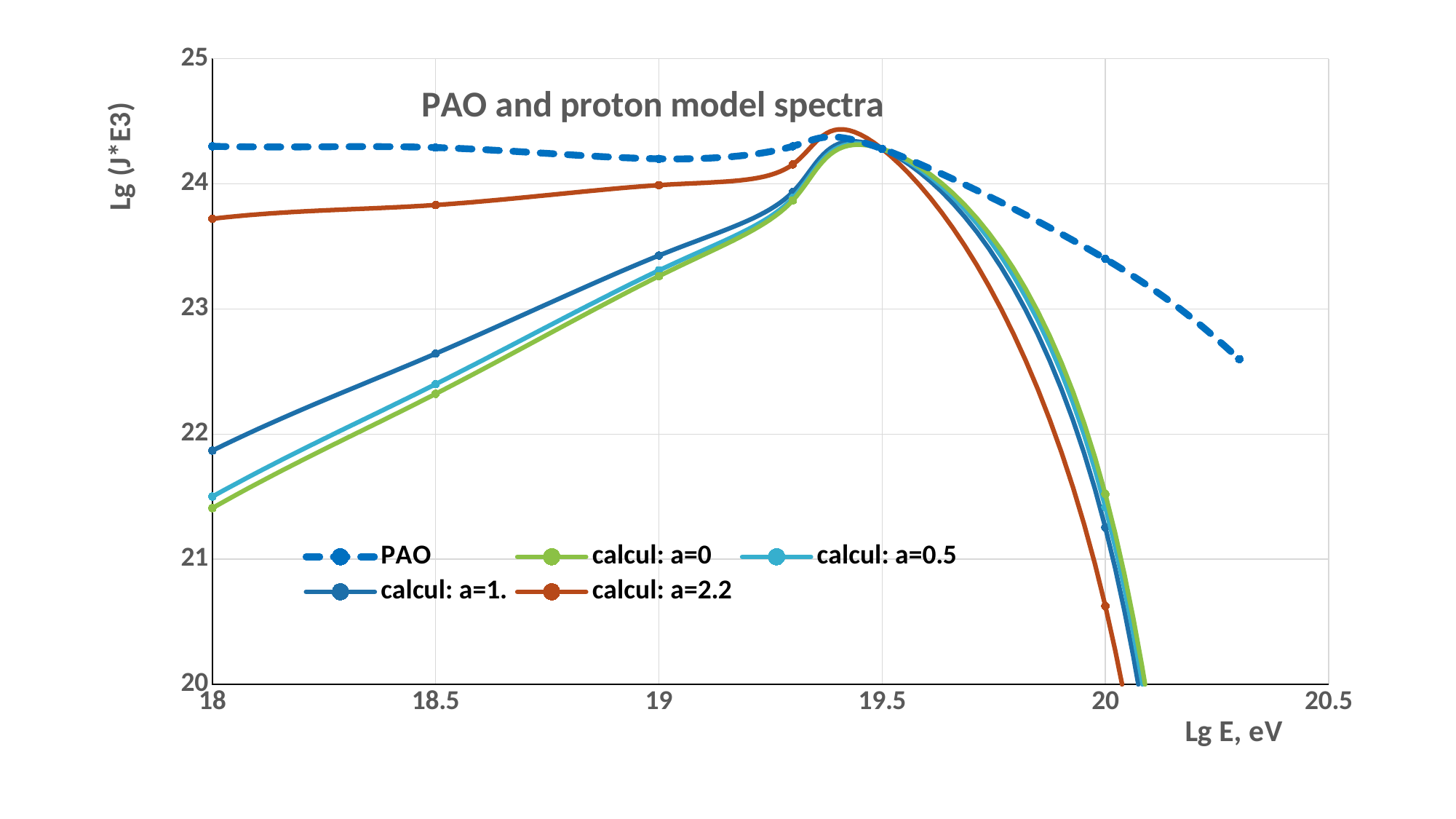
Is the value for calcul: a=1. at Lg E = 18 greater or less than 23? less How many series does the legend list? 5 What is the title of the chart? PAO and proton model spectra At Lg E = 18, which series has the highest value? PAO At Lg E = 18, which is larger: calcul: a=1. or calcul: a=0? calcul: a=1. Does the calcul: a=0 series rise or fall between Lg E = 18 and Lg E = 19.5? rise Is the value for calcul: a=2.2 at Lg E = 18 greater or less than 23? greater At Lg E = 20, which is larger: PAO or calcul: a=2.2? PAO At Lg E = 19, which series has the highest value? PAO What kind of chart is shown on the slide? line chart Is the value for PAO at Lg E = 20 greater or less than 23? greater Which series is drawn with a dashed line? PAO